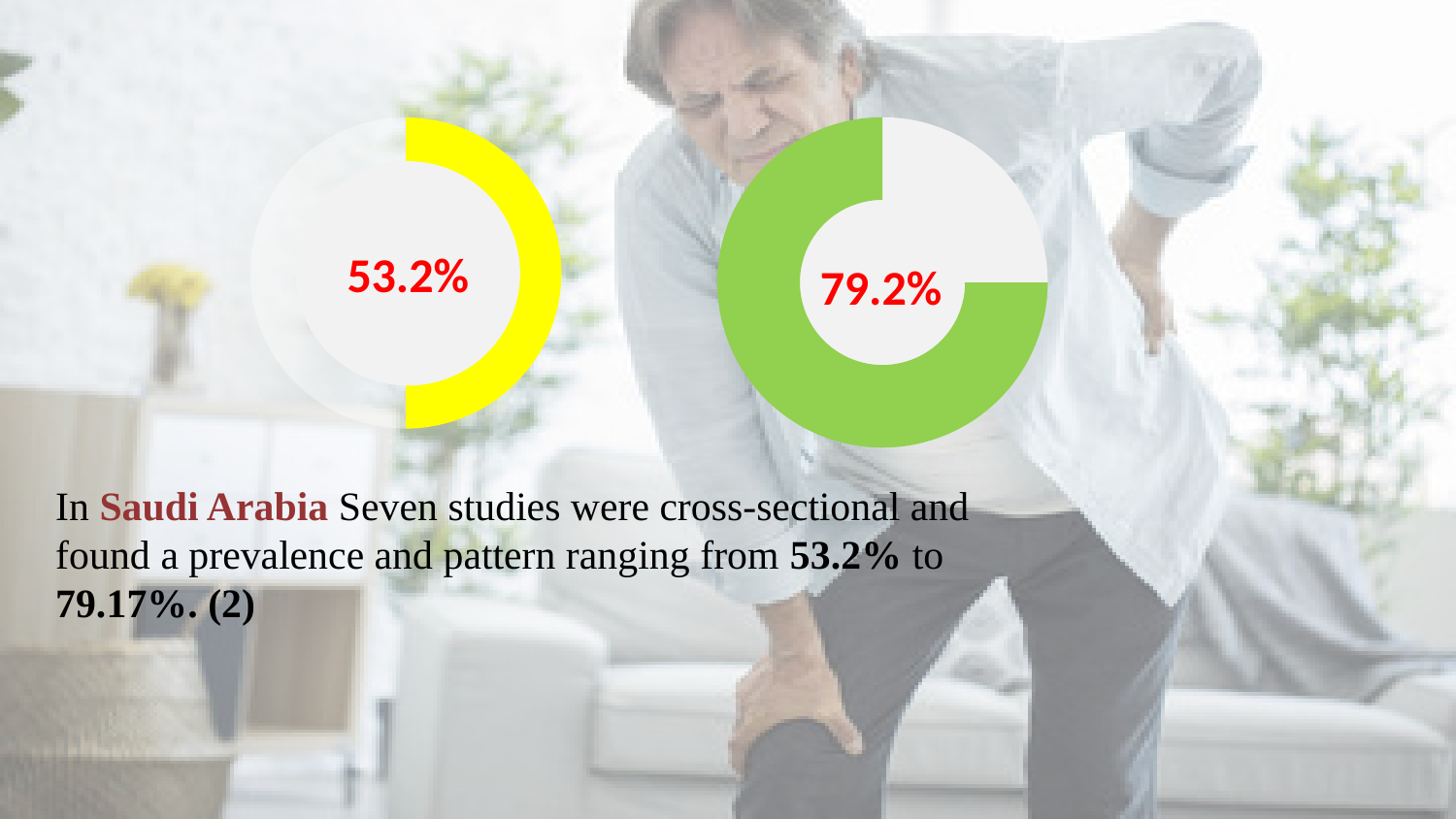
What value is shown in the centre of the left doughnut chart? 53.2% What colour is the filled portion of the left doughnut chart? yellow Is the value shown on the left doughnut chart greater or less than 50%? greater What is the difference between the value on the right doughnut chart and the value on the left doughnut chart? 26.0% What kind of chart is the right chart on the slide? doughnut chart What colour is the filled portion of the right doughnut chart? green Is the value shown on the right doughnut chart greater or less than 80%? less How many doughnut charts are shown on the slide? 2 What value is shown in the centre of the right doughnut chart? 79.2% What kind of chart is the left chart on the slide? doughnut chart Which of the two doughnut charts shows the larger value, the left or the right? the right Which doughnut chart shows the smaller value, the left or the right? the left